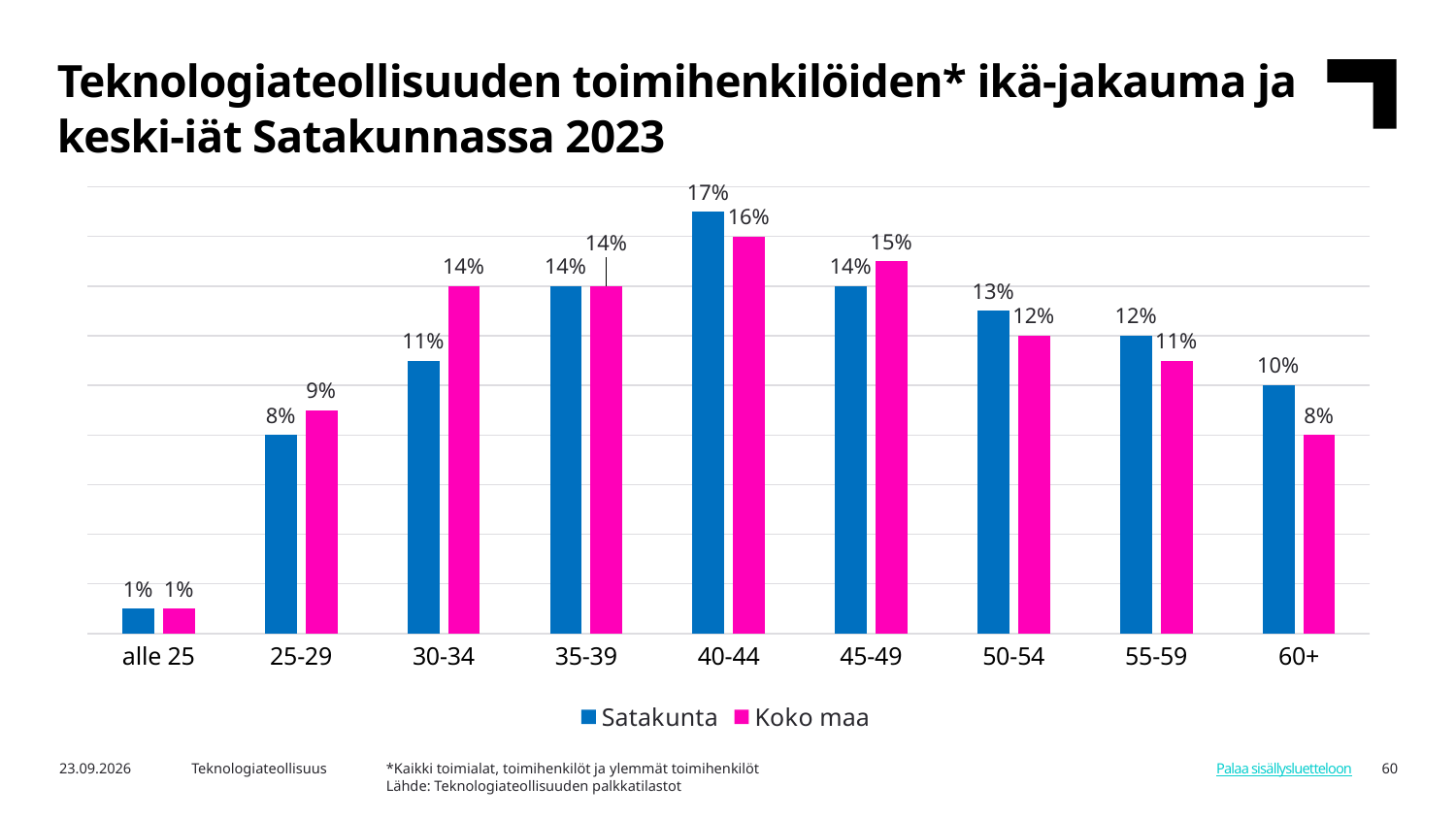
What is the value for Koko maa in the 30-34 age group? 14% What is the value for Satakunta in the 40-44 age group? 17% How many age groups are shown on the x axis? 9 Which age group has the lowest value for Satakunta? alle 25 What is the difference between the Satakunta values for 40-44 and 60+? 7 percentage points What is the difference between the Satakunta and Koko maa values in the 30-34 age group? 3 percentage points In the 45-49 age group, which series has the larger value, Satakunta or Koko maa? Koko maa Which age group has the highest value for Koko maa? 40-44 How many series does the legend list? 2 In the 55-59 age group, which series has the larger value, Satakunta or Koko maa? Satakunta What is the value for Satakunta in the 60+ age group? 10% What kind of chart is shown on the slide? Bar chart